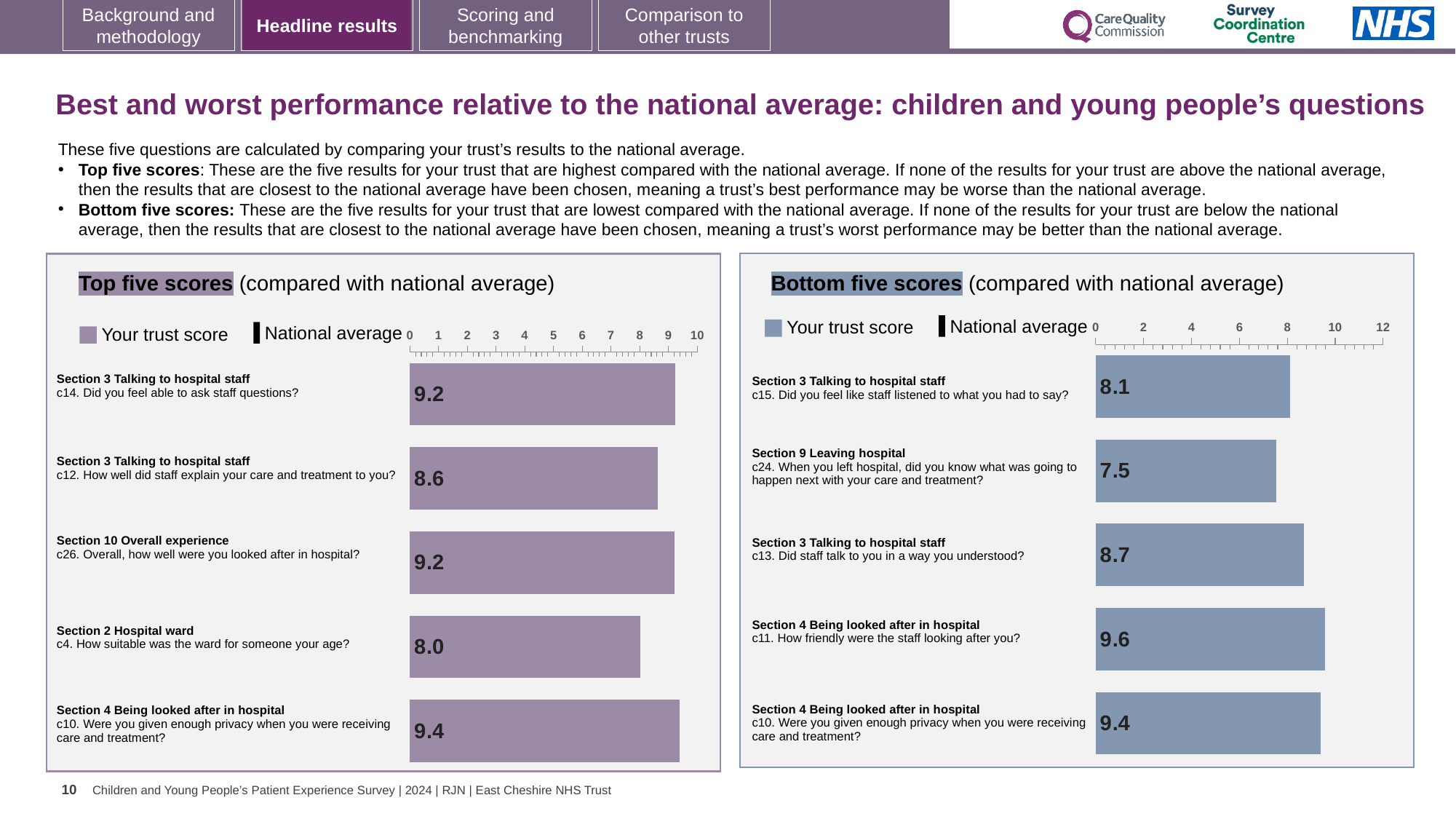
In the 'Top five scores' chart, which question has the highest trust score? c10. Were you given enough privacy when you were receiving care and treatment? In the 'Bottom five scores' chart, which question has the lowest trust score? c24. When you left hospital, did you know what was going to happen next with your care and treatment? In the 'Top five scores' chart, what is the trust score for c4 'How suitable was the ward for someone your age?' 8.0 What type of chart is the 'Top five scores' chart? Bar chart In the 'Top five scores' chart, which has the larger trust score: c12 or c10? c10 How many questions are shown in the 'Bottom five scores' chart? 5 In the 'Top five scores' chart, what is the trust score for c14 'Did you feel able to ask staff questions?' 9.2 In the 'Bottom five scores' chart, what is the difference between the trust scores for c11 and c24? 2.1 In the 'Bottom five scores' chart, what is the trust score for c24 'When you left hospital, did you know what was going to happen next with your care and treatment?' 7.5 In the 'Top five scores' chart, which question has the lowest trust score? c4. How suitable was the ward for someone your age? How many series does the legend of the 'Top five scores' chart list? 2 In the 'Bottom five scores' chart, what is the trust score for c11 'How friendly were the staff looking after you?' 9.6